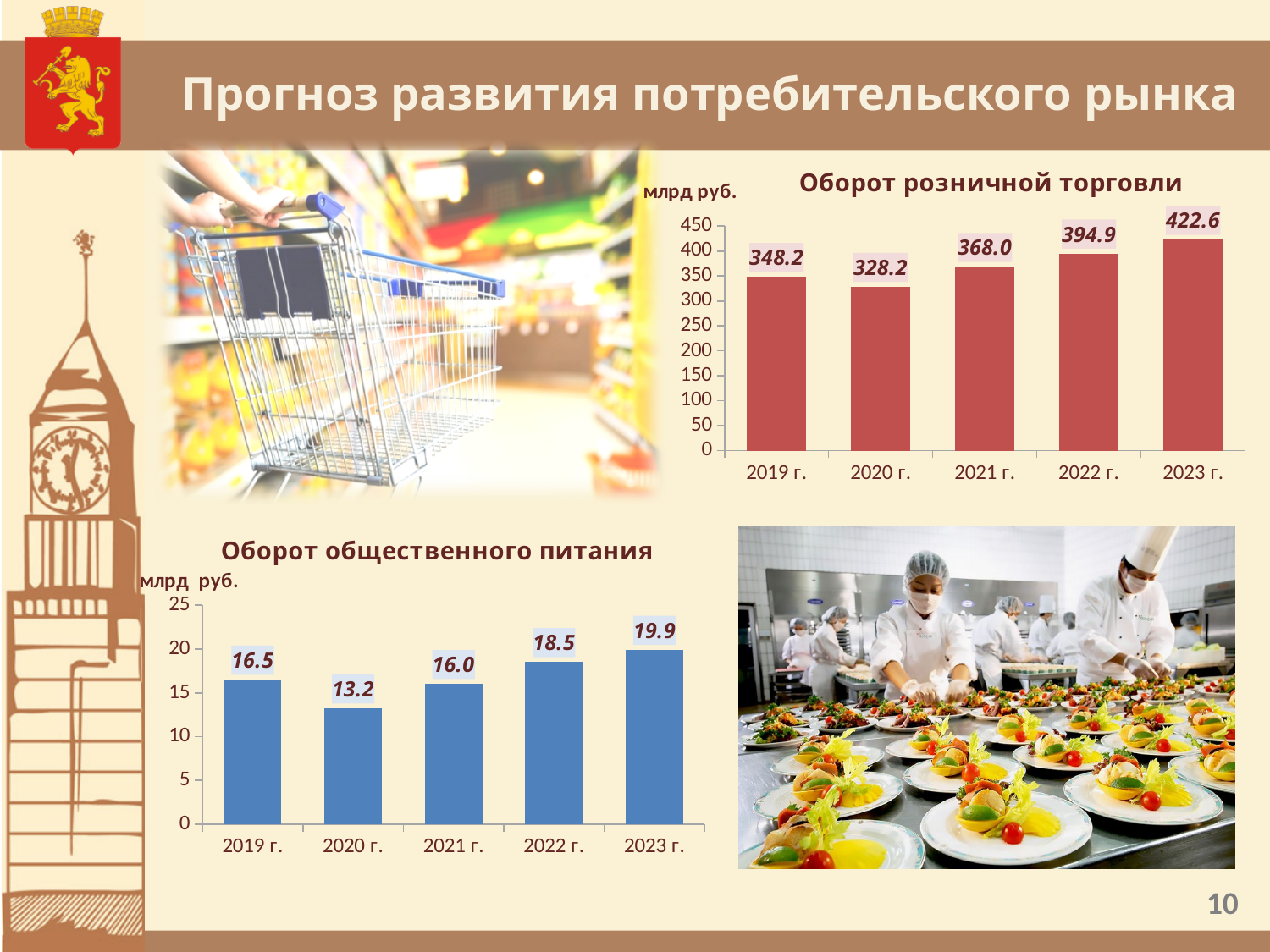
In the chart titled "Оборот розничной торговли", which year has the lowest value? 2020 г. In the chart titled "Оборот розничной торговли", what is the value for 2021 г.? 368.0 In the chart titled "Оборот общественного питания", what is the value for 2020 г.? 13.2 In the chart titled "Оборот общественного питания", what is the difference between the values for 2023 г. and 2022 г.? 1.4 In the chart titled "Оборот розничной торговли", how many years are shown on the x axis? 5 In the chart titled "Оборот розничной торговли", what is the difference between the values for 2023 г. and 2019 г.? 74.4 In the chart titled "Оборот общественного питания", which is larger, the value for 2019 г. or the value for 2021 г.? 2019 г. In the chart titled "Оборот общественного питания", do the values rise or fall from 2020 г. to 2023 г.? rise In the chart titled "Оборот розничной торговли", is the value for 2022 г. greater or less than 400? less What unit is shown on the axis label of the chart titled "Оборот розничной торговли"? млрд руб. What kind of chart is the one titled "Оборот общественного питания"? bar chart In the chart titled "Оборот розничной торговли", which year has the highest value? 2023 г.